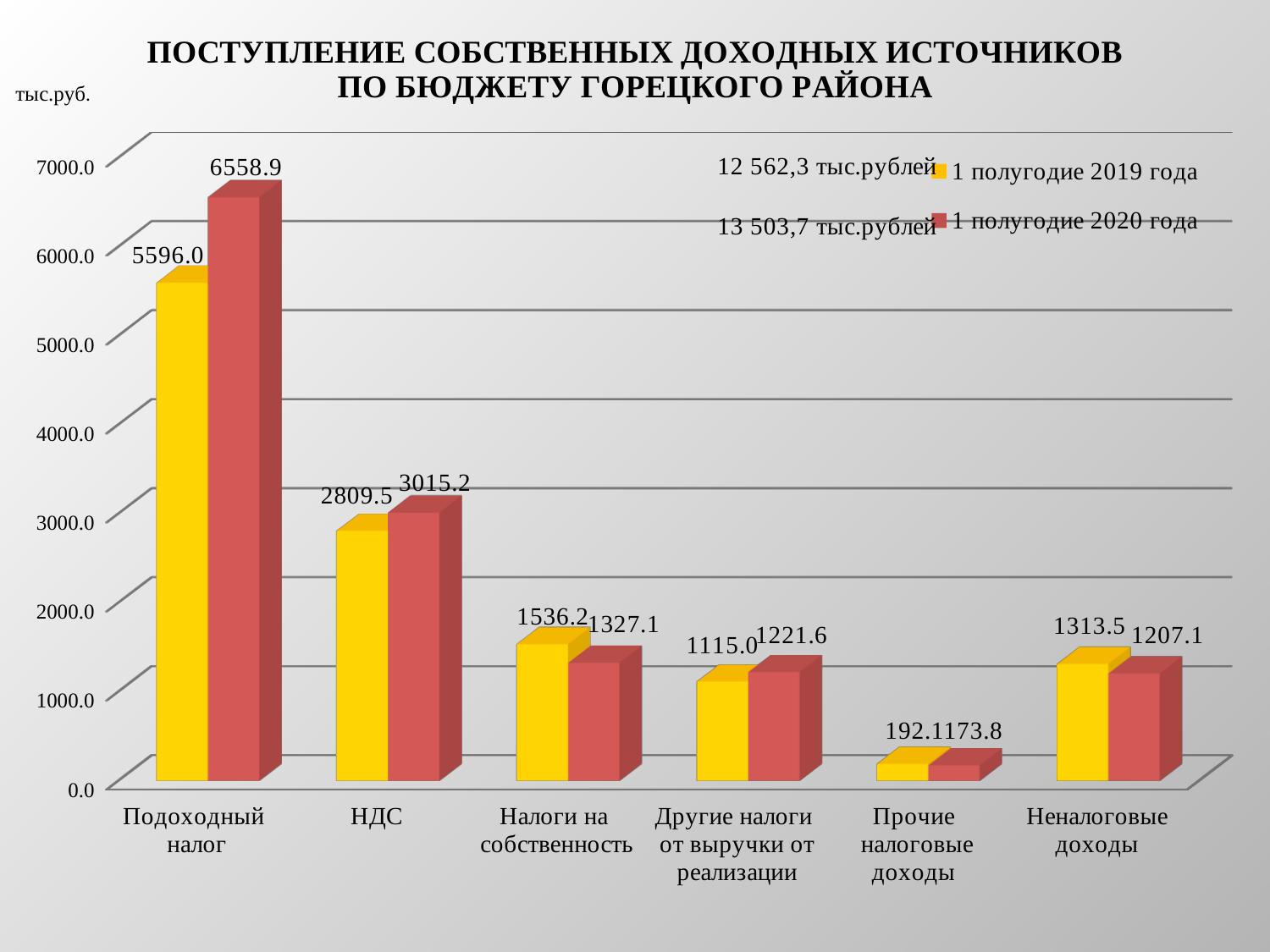
What is the difference between the 1 полугодие 2020 года and 1 полугодие 2019 года values for Подоходный налог? 962.9 What is the value for Подоходный налог in 1 полугодие 2020 года? 6558.9 What colour are the bars for 1 полугодие 2020 года? red How many categories are shown on the x axis? 6 What is the value for Неналоговые доходы in 1 полугодие 2019 года? 1313.5 How many series does the legend list? 2 What is the value for Подоходный налог in 1 полугодие 2019 года? 5596.0 Which category has the highest value in 1 полугодие 2020 года? Подоходный налог What is the value for НДС in 1 полугодие 2020 года? 3015.2 Which is larger for Налоги на собственность: the value for 1 полугодие 2019 года or for 1 полугодие 2020 года? 1 полугодие 2019 года Which category has the lowest value in 1 полугодие 2019 года? Прочие налоговые доходы What kind of chart is shown on the slide? bar chart